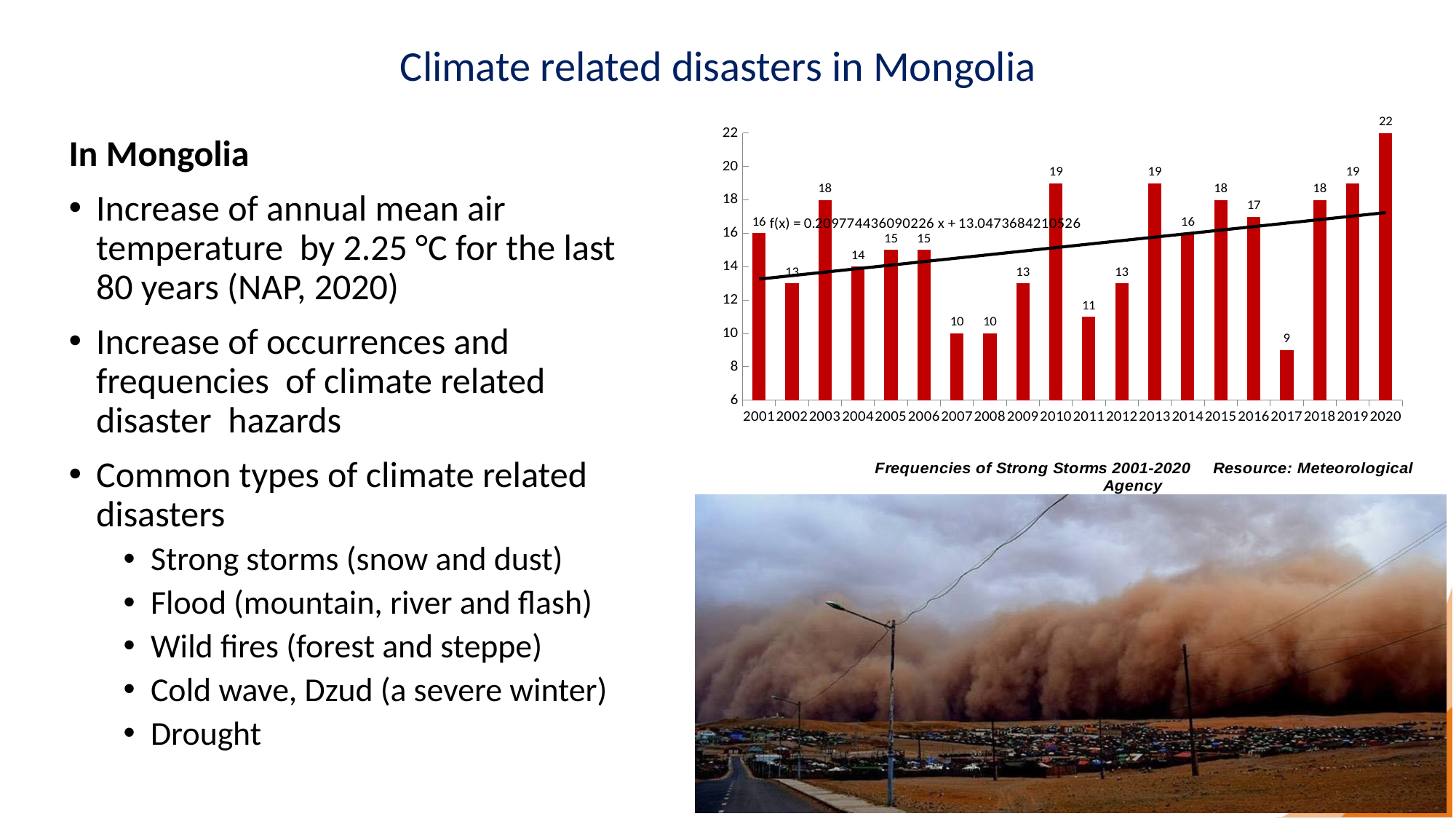
What is the value for 2020 in the strong storms chart? 22 What is the value for 2017 in the strong storms chart? 9 What is the difference between the values for 2003 and 2002 in the strong storms chart? 5 What is the value for 2001 in the strong storms chart? 16 Does the trend line in the strong storms chart rise or fall from 2001 to 2020? Rise What is the difference between the values for 2020 and 2017 in the strong storms chart? 13 How many years are shown on the x axis of the strong storms chart? 20 What kind of chart is used to show the frequencies of strong storms? Bar chart Which year has the highest value in the strong storms chart? 2020 Which is larger in the strong storms chart, the value for 2016 or the value for 2011? 2016 What is the value for 2010 in the strong storms chart? 19 Which year has the lowest value in the strong storms chart? 2017